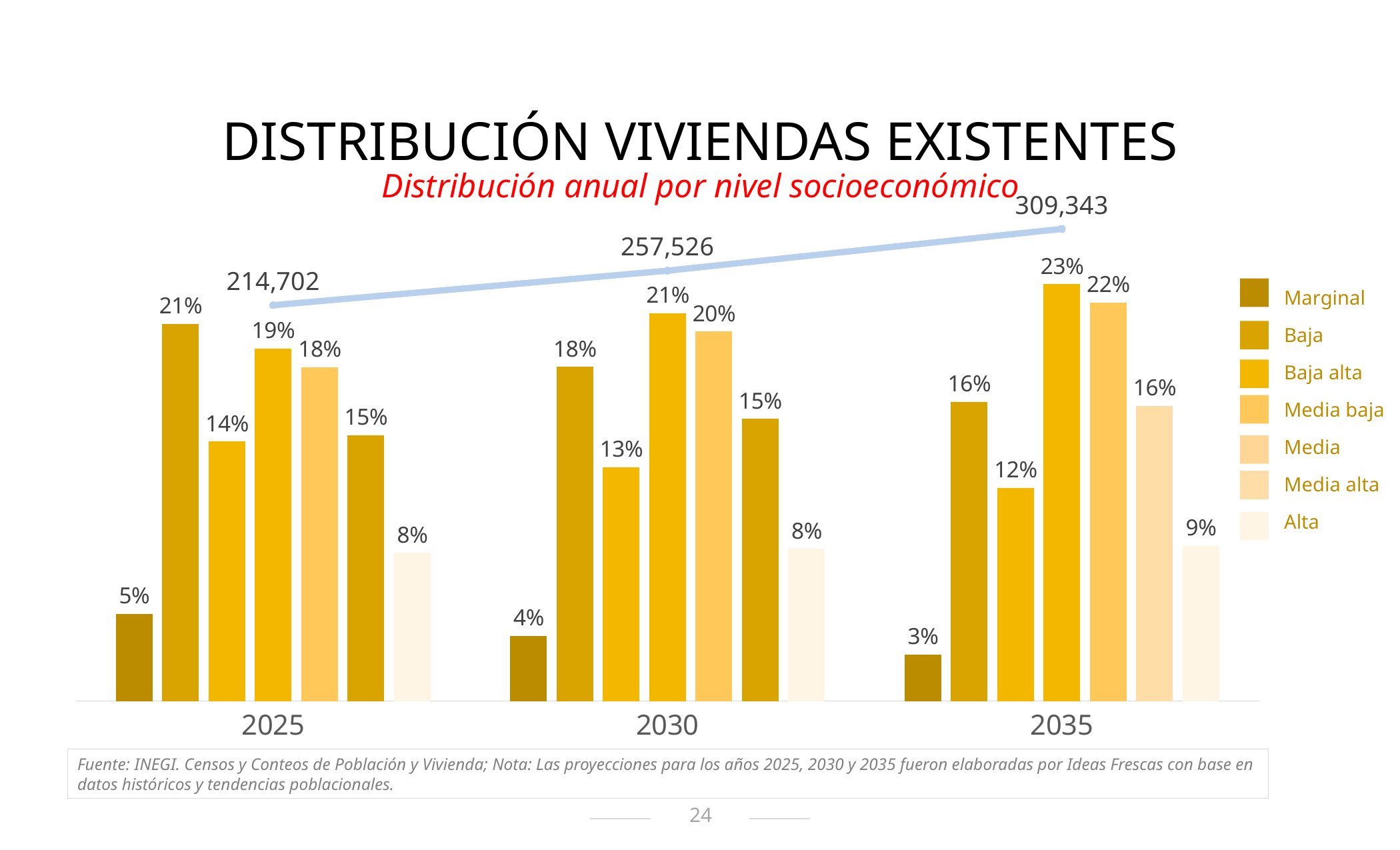
What kind of chart is used to show the socioeconomic levels? Bar chart How many years are shown on the x axis? 3 How many series does the legend list? 7 What is the value for Alta in 2035? 9% What is the value for Marginal in 2025? 5% Which is larger in 2030, the value for Media or the value for Baja? Media What total is shown on the line for 2030? 257,526 What is the value for Media baja in 2035? 23% Do the totals shown on the line rise or fall from 2025 to 2035? Rise Which socioeconomic level has the lowest value in 2030? Marginal Which socioeconomic level has the highest value in 2035? Media baja What is the difference between the Baja value in 2025 and the Baja value in 2035? 5 percentage points